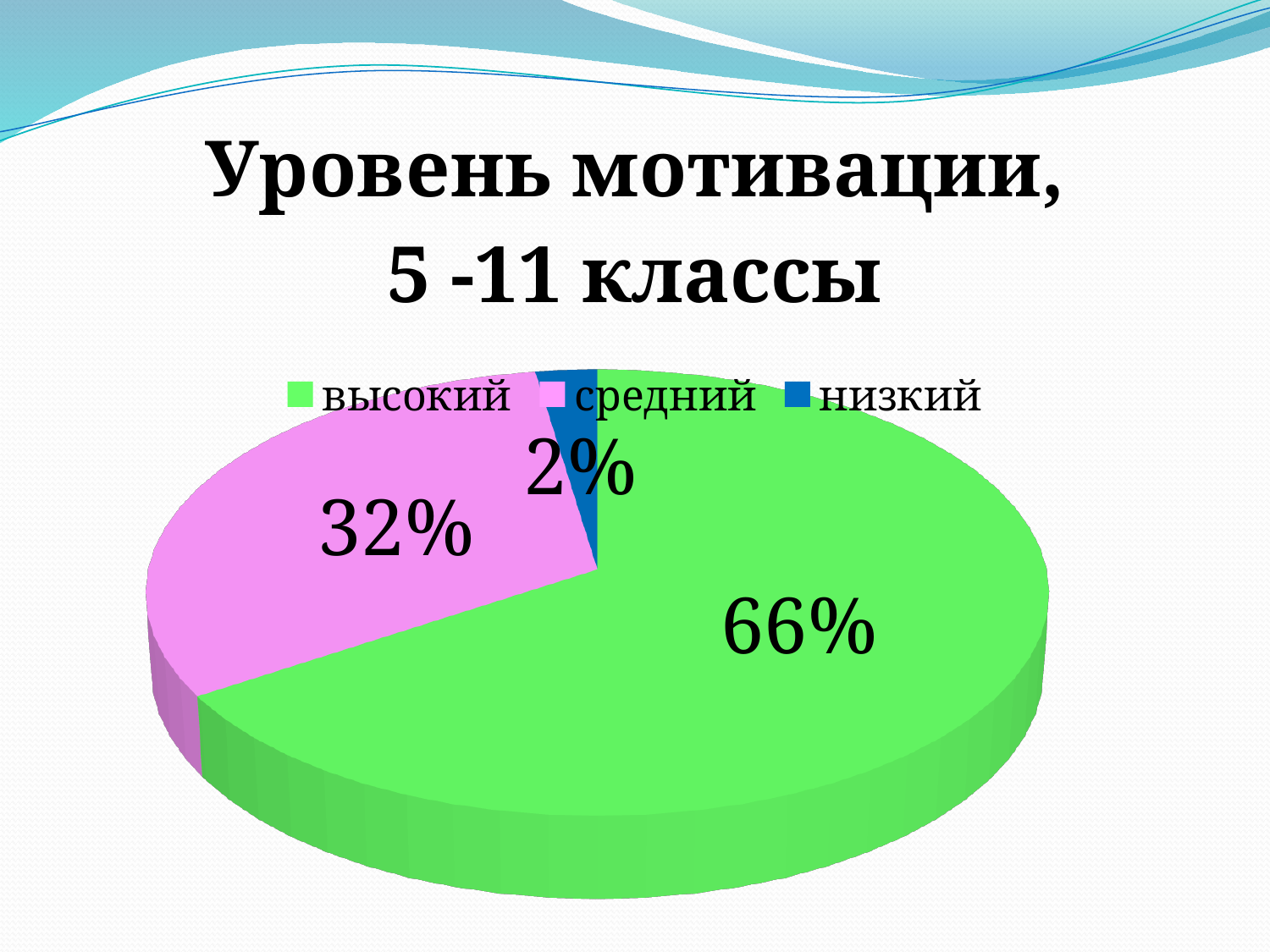
What kind of chart is shown on the slide? pie chart What share of the pie does the 'высокий' slice represent? 66% What is the difference between the 'высокий' and 'средний' values? 34% What is the value shown for 'низкий'? 2% How many categories are shown in the pie chart? 3 Which category has the largest slice of the pie? высокий Which colour represents the 'средний' category in the legend? pink Which is larger, the value for 'средний' or the value for 'низкий'? средний Which category has the smallest slice of the pie? низкий What is the difference between the 'средний' and 'низкий' values? 30% What is the title of the chart? Уровень мотивации, 5 -11 классы What is the value shown for 'средний'? 32%